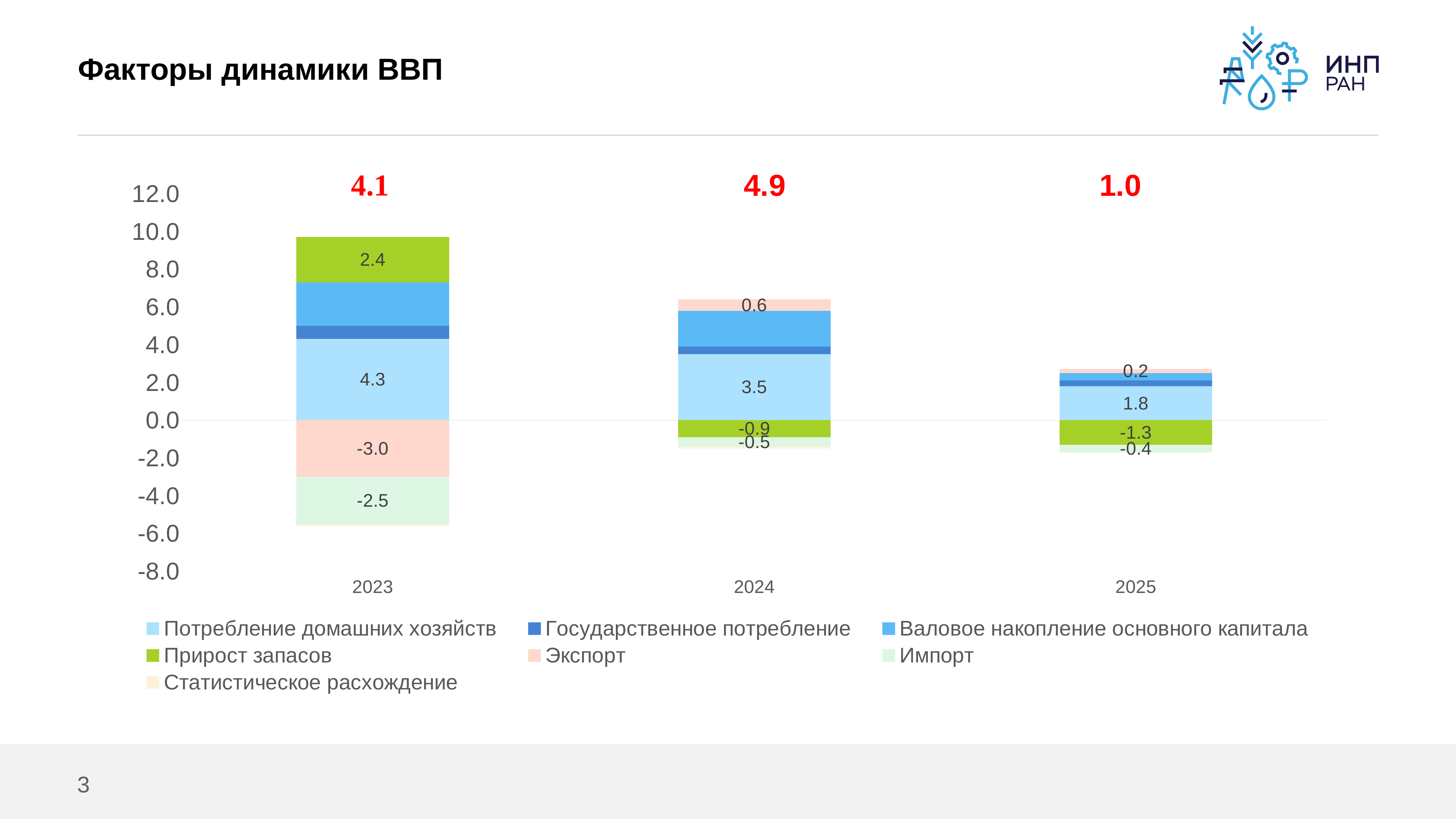
How many series does the legend list? 7 What is the value of Импорт for 2023? -2.5 Does Потребление домашних хозяйств rise or fall from 2023 to 2025? fall Which year has the highest red total figure above its bar? 2024 What is the value of Экспорт for 2024? 0.6 What is the red total figure shown above the 2024 bar? 4.9 How many years are shown on the x axis? 3 Which is larger: Экспорт in 2024 or Экспорт in 2025? Экспорт in 2024 What is the difference between Потребление домашних хозяйств in 2023 and in 2025? 2.5 Which year has the lowest red total figure above its bar? 2025 What is the value of Потребление домашних хозяйств for 2023? 4.3 What is the value of Прирост запасов for 2025? -1.3